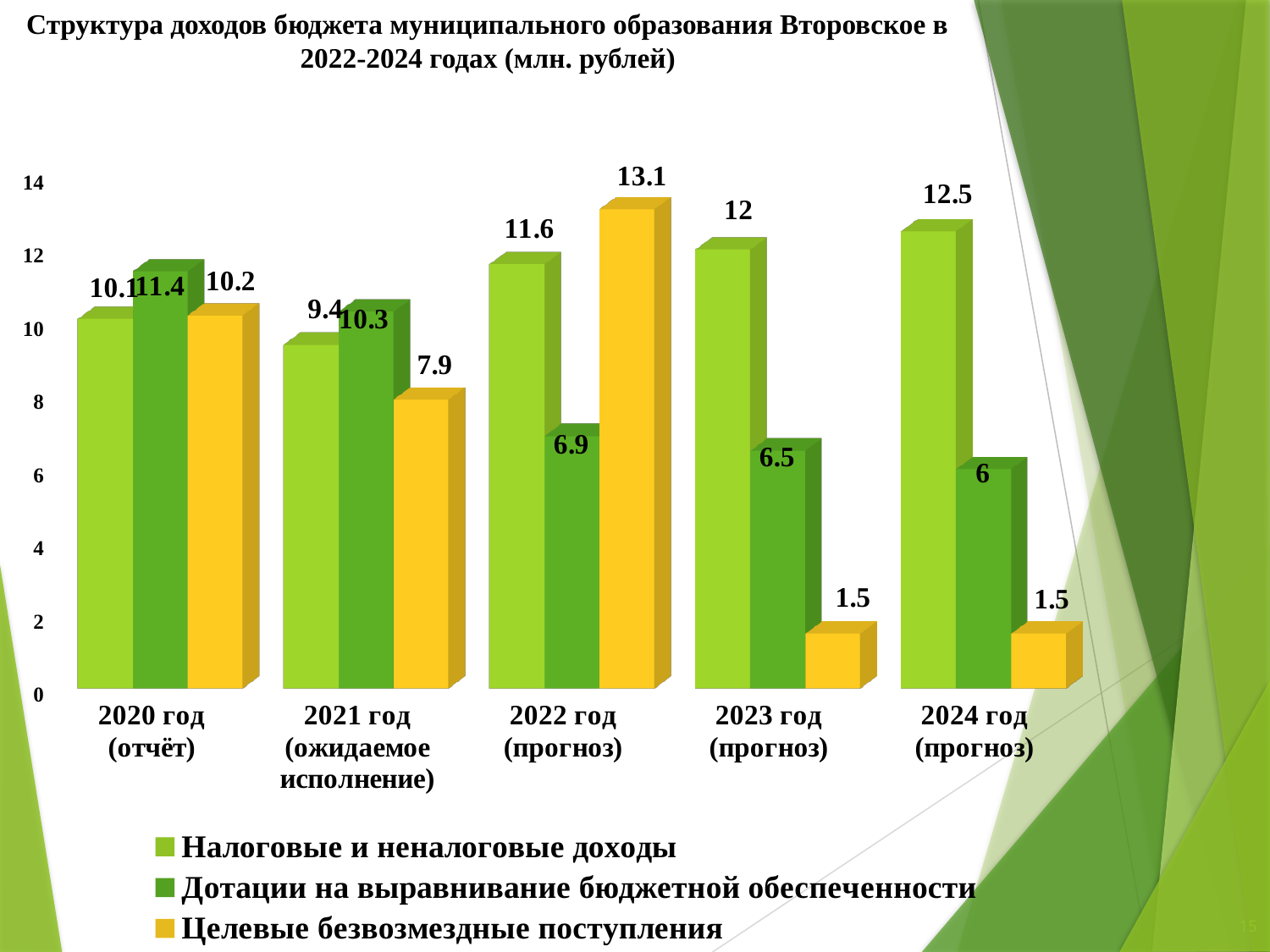
In which year is the value of Дотации на выравнивание бюджетной обеспеченности lowest? 2024 год (прогноз) What kind of chart is shown on the slide? Bar chart In which year is the value of Налоговые и неналоговые доходы highest? 2024 год (прогноз) What is the value of Налоговые и неналоговые доходы for 2022 год (прогноз)? 11.6 Which colour represents Целевые безвозмездные поступления in the legend? Yellow What is the value of Целевые безвозмездные поступления for 2021 год (ожидаемое исполнение)? 7.9 Which is larger in 2021 год (ожидаемое исполнение): Налоговые и неналоговые доходы or Дотации на выравнивание бюджетной обеспеченности? Дотации на выравнивание бюджетной обеспеченности How many year categories are shown on the x axis? 5 What is the difference between Целевые безвозмездные поступления in 2022 год (прогноз) and in 2023 год (прогноз)? 11.6 How many series does the legend list? 3 What is the value of Дотации на выравнивание бюджетной обеспеченности for 2020 год (отчёт)? 11.4 Does the value of Дотации на выравнивание бюджетной обеспеченности rise or fall from 2021 год to 2024 год? Fall